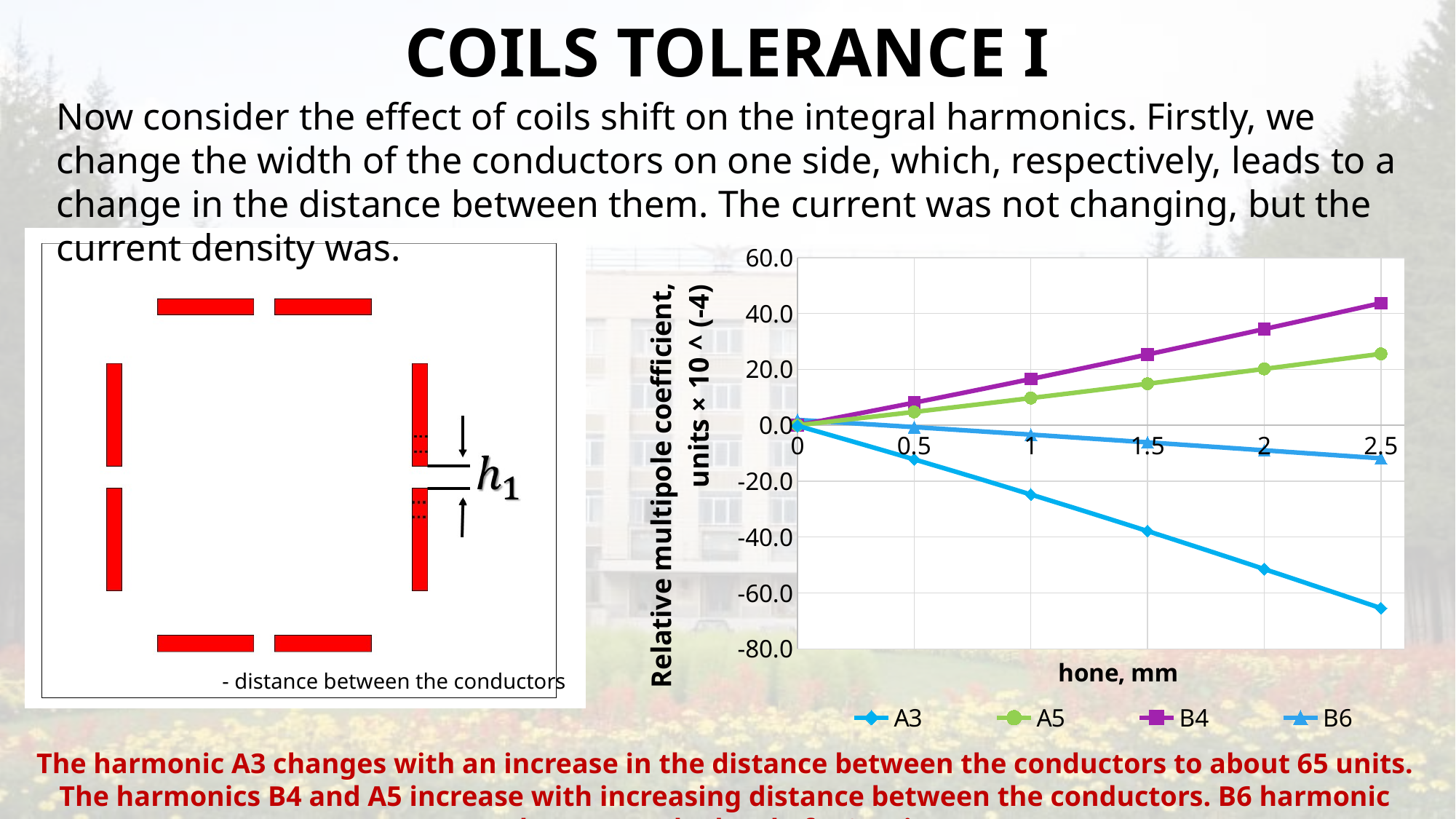
Does the B4 series rise or fall as hone increases from 0 to 2.5 mm? rise Is the value for A3 at hone = 2.5 mm greater or less than -60.0? less At hone = 2.5 mm, which is larger, B4 or A5? B4 Which series has the highest value at hone = 2.5 mm? B4 Does the A3 series rise or fall as hone increases from 0 to 2.5 mm? fall How many x-axis points (hone values) are plotted for each series? 6 How many series does the chart legend list? 4 What is the title of the x axis of the chart? hone, mm What kind of chart is shown on the slide? line chart Which series has the lowest value at hone = 2.5 mm? A3 Is the value for B4 at hone = 2.5 mm greater or less than 40.0? greater Is the value for B6 at hone = 2.5 mm greater or less than -20.0? greater